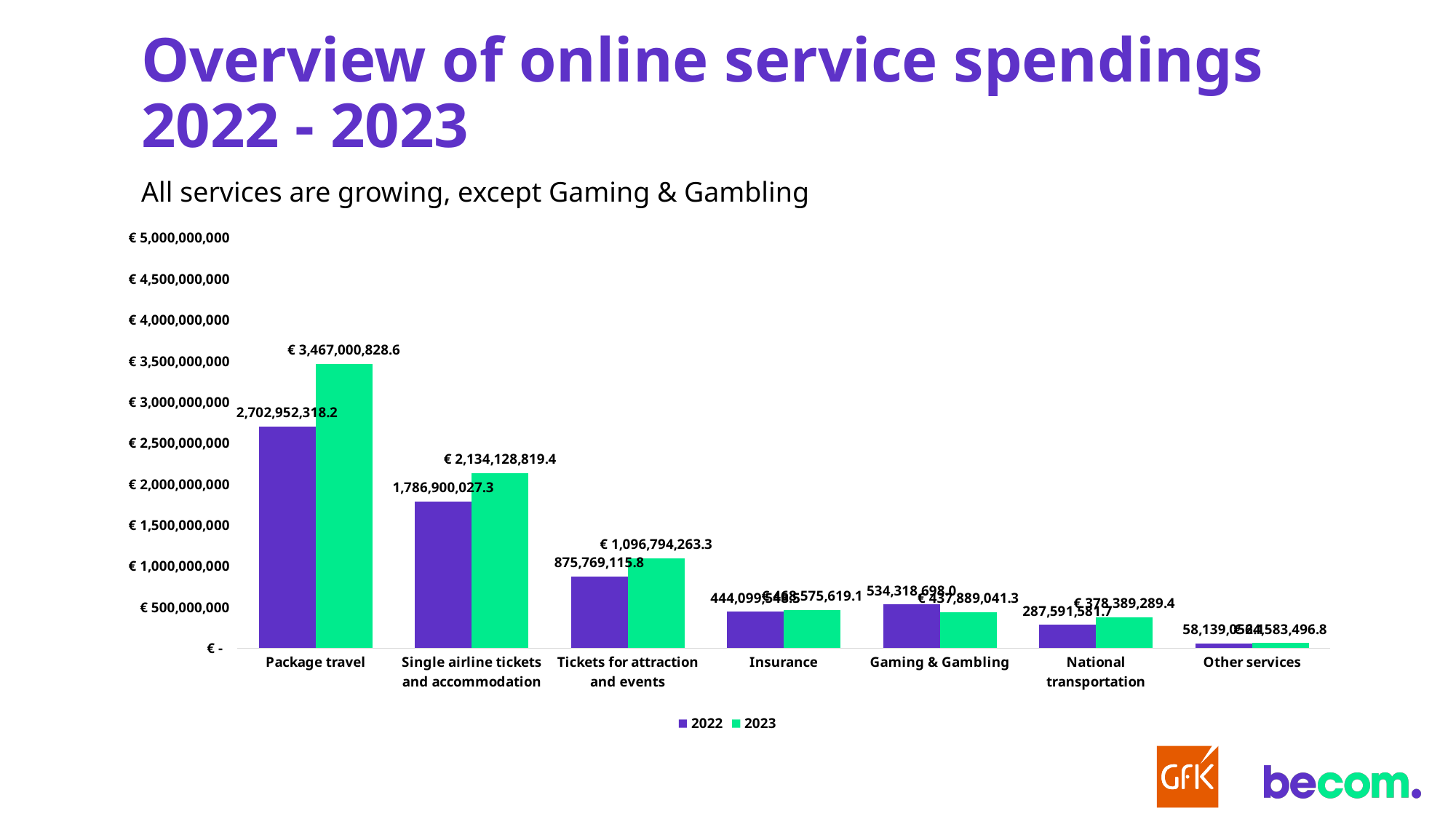
Which category has the highest 2023 spending? Package travel How many series does the legend list? 2 What is the 2022 value for Single airline tickets and accommodation? 1,786,900,027.3 For Gaming & Gambling, which year has the larger value, 2022 or 2023? 2022 What is the 2022 value for Gaming & Gambling? 534,318,698.0 How many service categories are shown on the x axis? 7 Is the 2022 value for Tickets for attraction and events greater or less than € 1,000,000,000? less What is the difference between the 2023 and 2022 values for Package travel? 764,048,510.4 What is the 2023 value for National transportation? € 378,389,289.4 What is the 2023 value for Package travel? € 3,467,000,828.6 Which category has the lowest 2022 spending? Other services What kind of chart is shown on the slide? Bar chart